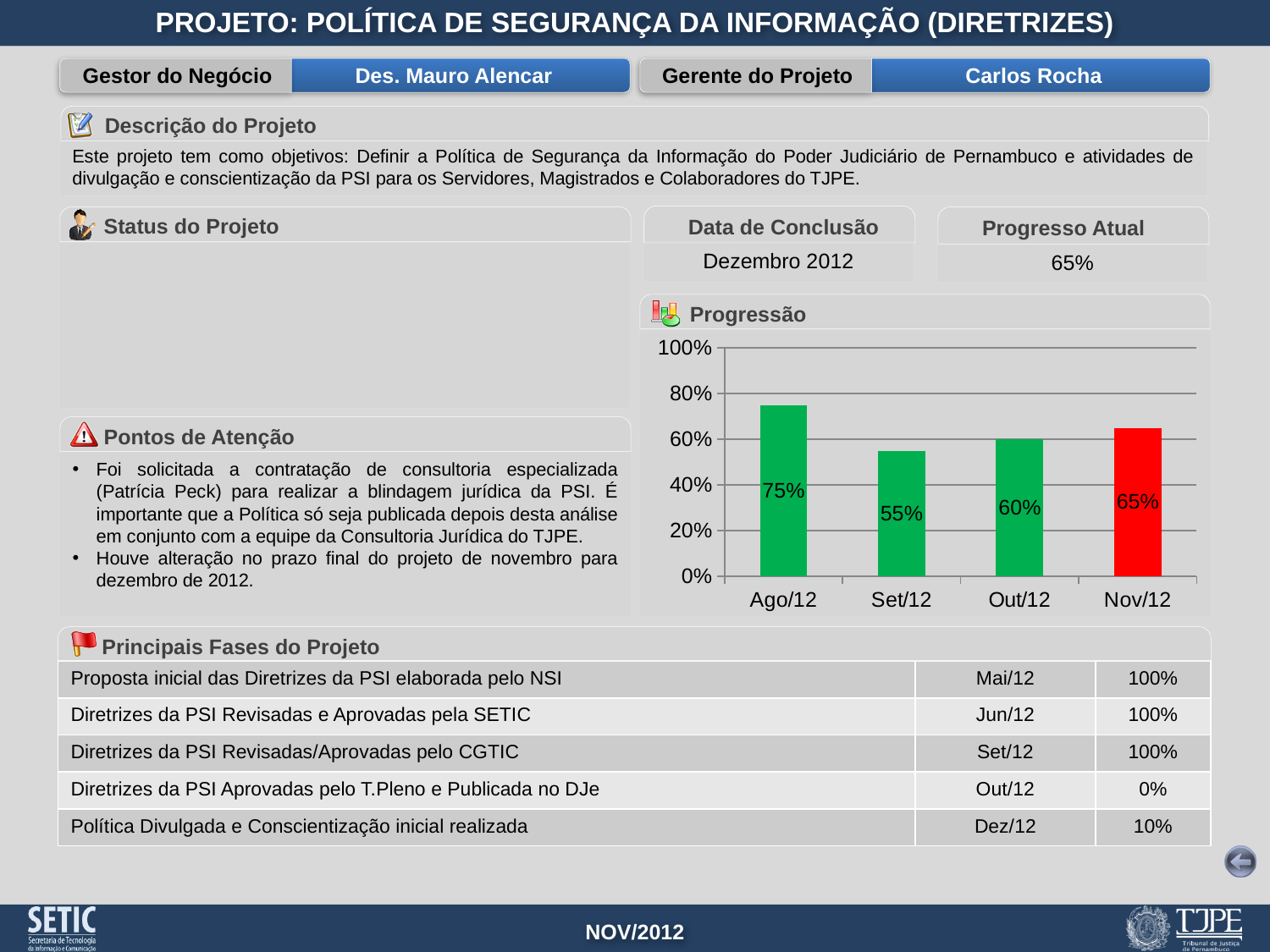
What is the value for Set/12 in the Progressão chart? 55% What kind of chart is the Progressão chart? bar chart Which bar in the Progressão chart is coloured red? Nov/12 What is the value for Out/12 in the Progressão chart? 60% What is the value for Ago/12 in the Progressão chart? 75% Which is larger in the Progressão chart, the value for Out/12 or Nov/12? Nov/12 Which month has the highest value in the Progressão chart? Ago/12 What is the difference between the values for Ago/12 and Set/12 in the Progressão chart? 20% How many months are shown on the x axis of the Progressão chart? 4 What is the value for Nov/12 in the Progressão chart? 65% Which month has the lowest value in the Progressão chart? Set/12 Is the value for Set/12 in the Progressão chart greater or less than 60%? less